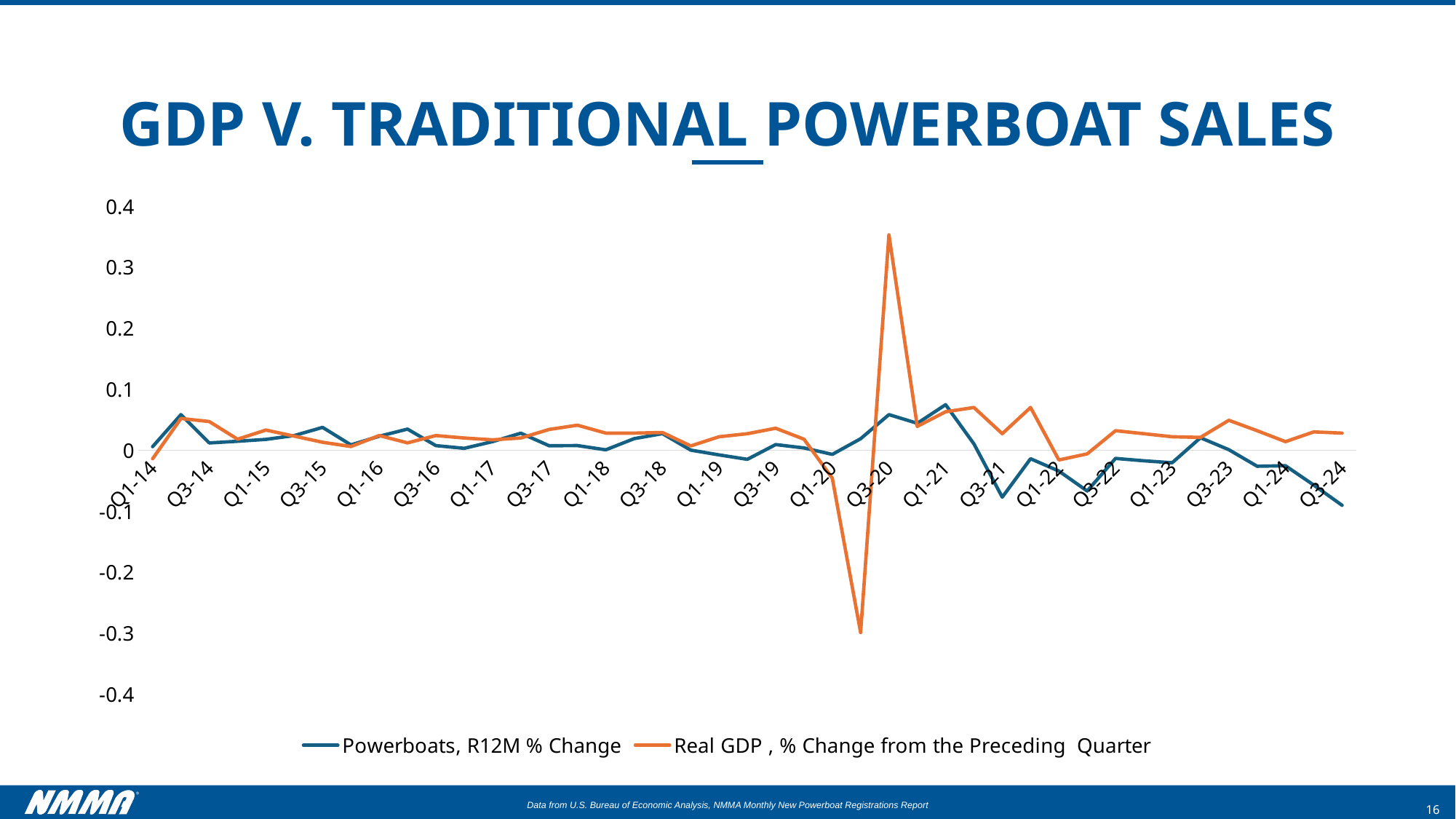
Does the Powerboats, R12M % Change series rise or fall from Q1-24 to Q3-24? fall What kind of chart is shown on the slide? Line chart At Q3-20, which series has the larger value, Powerboats or Real GDP? Real GDP , % Change from the Preceding Quarter Is the value of the Powerboats, R12M % Change series at Q3-24 greater or less than 0? less What is the title of the chart on the slide? GDP V. TRADITIONAL POWERBOAT SALES Is the peak value of the Real GDP series at Q3-20 greater or less than 0.3? greater How many series does the legend list? 2 Which series reaches the lowest value on the chart? Real GDP , % Change from the Preceding Quarter Which series reaches the highest value on the chart? Real GDP , % Change from the Preceding Quarter How many quarter labels are shown on the x axis? 22 Is the lowest value of the Real GDP series greater or less than -0.2? less Which colour is used for the Real GDP, % Change from the Preceding Quarter series? Orange